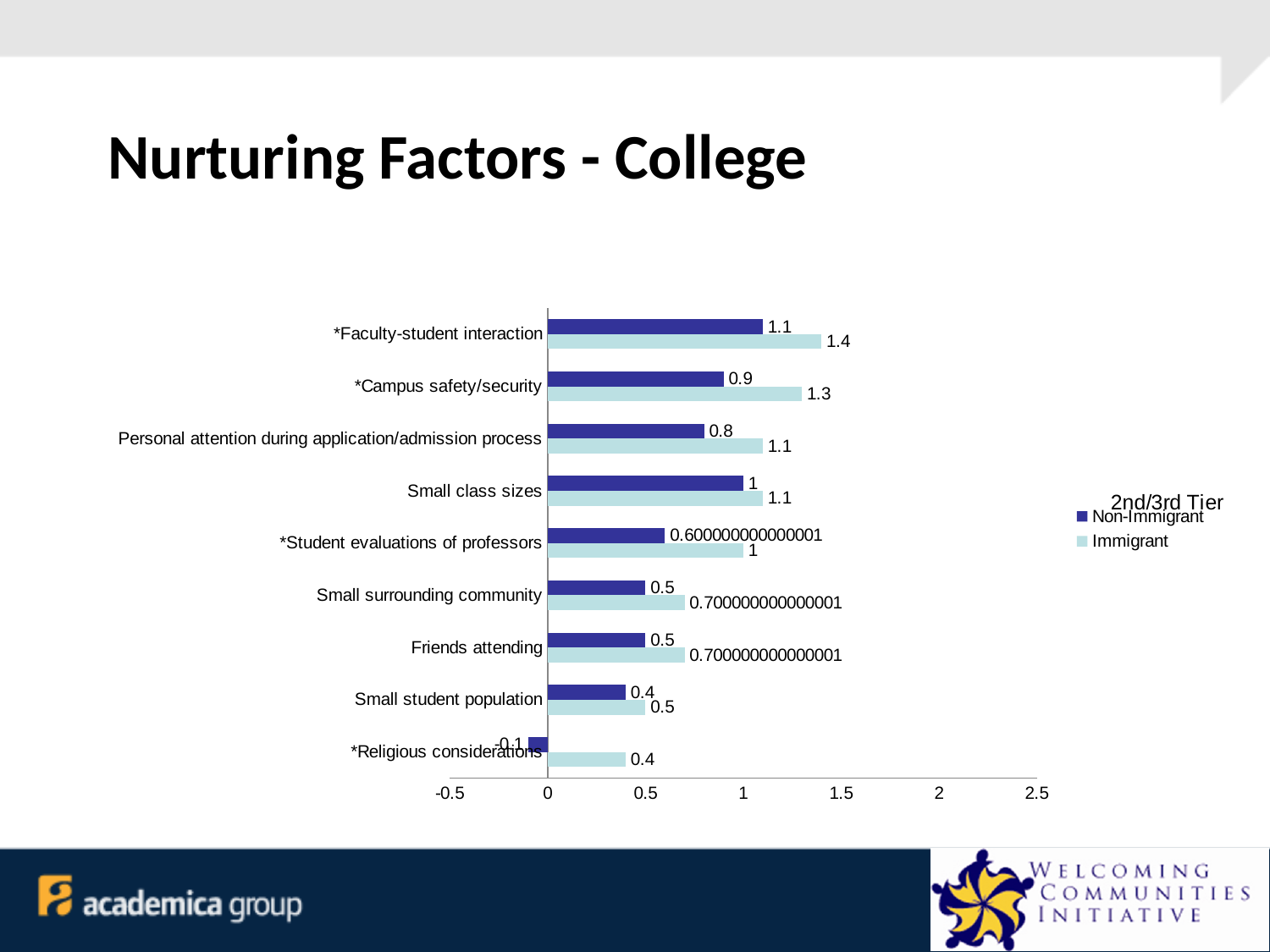
Which category has the highest Immigrant value? *Faculty-student interaction What kind of chart is shown on the slide? Bar chart Is the Immigrant value for *Campus safety/security greater or less than 1? greater What is the Non-Immigrant value for *Campus safety/security? 0.9 What is the difference between the Immigrant and Non-Immigrant values for *Campus safety/security? 0.4 What is the Immigrant value for *Faculty-student interaction? 1.4 How many categories are shown on the chart? 9 Which category has the lowest Non-Immigrant value? *Religious considerations For Small class sizes, which series has the larger value, Non-Immigrant or Immigrant? Immigrant What is the Immigrant value for *Religious considerations? 0.4 What is the Non-Immigrant value for Personal attention during application/admission process? 0.8 How many series does the legend list? 2